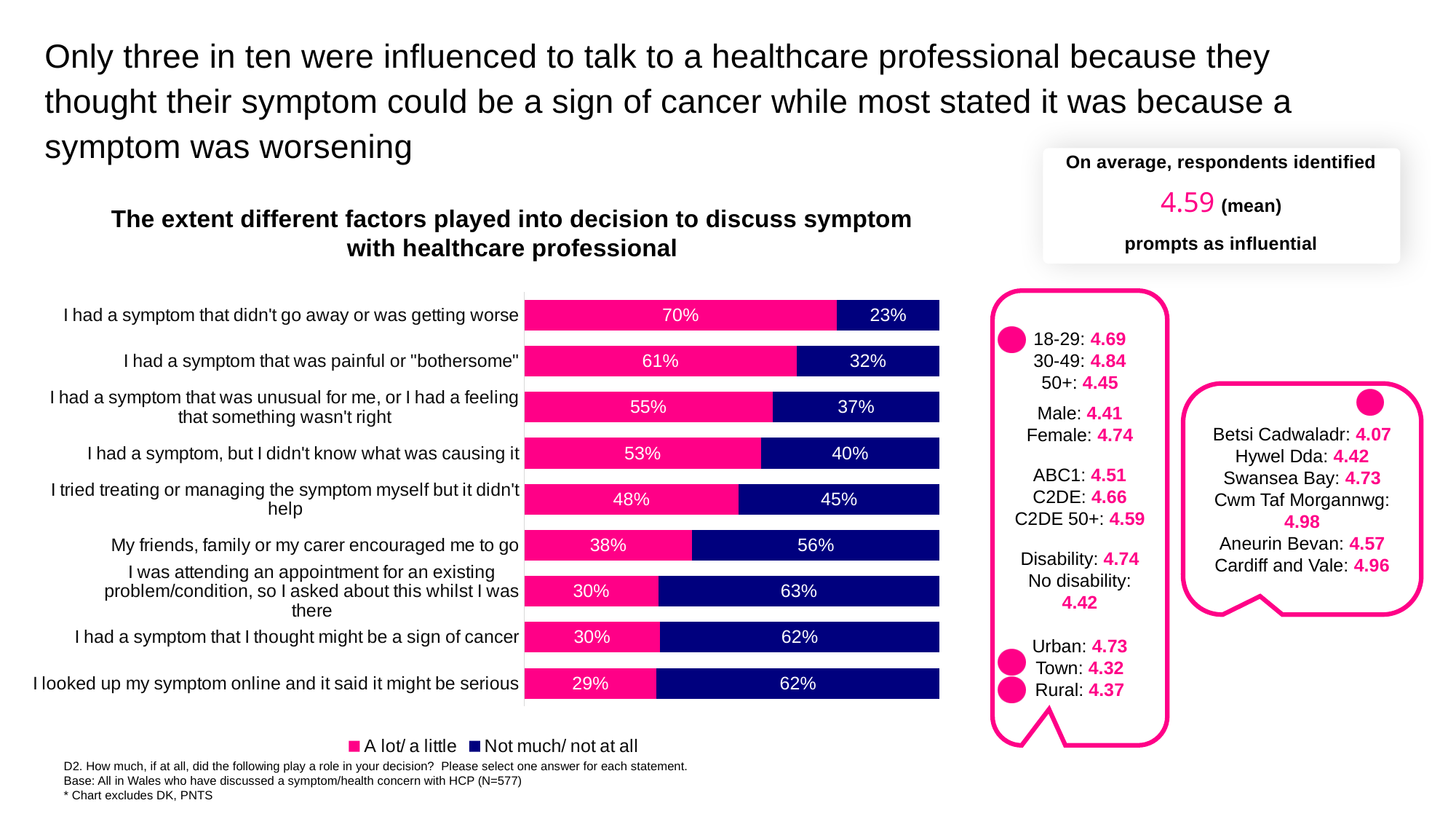
How many statements (categories) are plotted in the chart? 9 What is the difference between the 'A lot/ a little' and 'Not much/ not at all' values for 'I had a symptom that was painful or "bothersome"'? 29 percentage points Which colour represents the 'Not much/ not at all' series in the chart? Dark blue What is the 'A lot/ a little' value for 'I had a symptom that I thought might be a sign of cancer'? 30% How many series does the chart legend list? 2 What is the combined total of the two segments for 'I had a symptom, but I didn't know what was causing it'? 93% Which statement has the highest 'A lot/ a little' percentage? I had a symptom that didn't go away or was getting worse Which statement has the lowest 'A lot/ a little' percentage? I looked up my symptom online and it said it might be serious What percentage said 'Not much/ not at all' for 'My friends, family or my carer encouraged me to go'? 56% What kind of chart is shown on the slide? Stacked bar chart What percentage said 'A lot/ a little' for 'I had a symptom that didn't go away or was getting worse'? 70% Which is larger for 'I tried treating or managing the symptom myself but it didn't help': the 'A lot/ a little' value or the 'Not much/ not at all' value? A lot/ a little